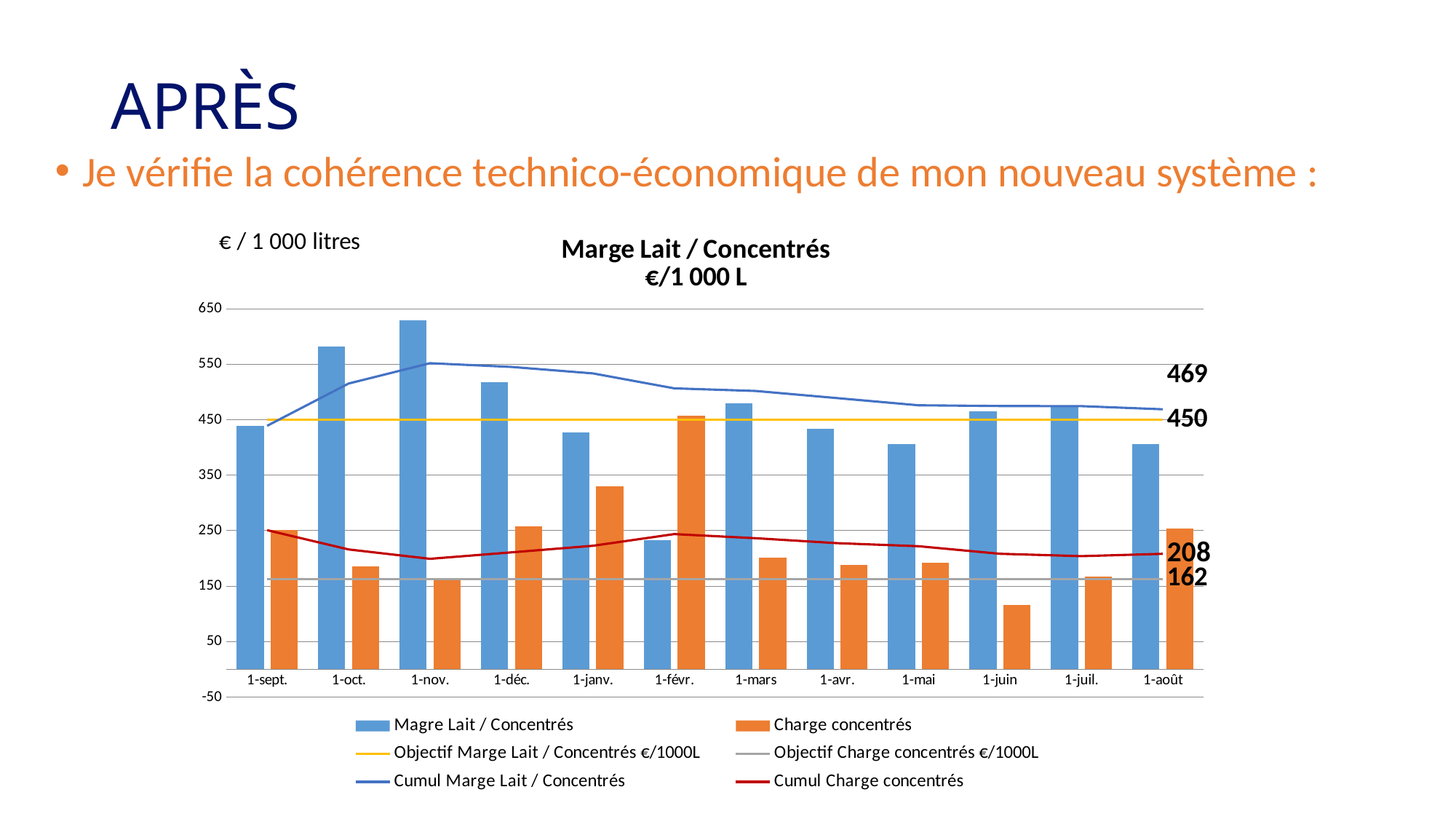
Is the Magre Lait / Concentrés value for 1-nov. greater or less than 550? greater In which month is the Magre Lait / Concentrés bar the highest? 1-nov. Which is larger, the Magre Lait / Concentrés bar for 1-oct. or for 1-déc.? 1-oct. What is the difference between the Cumul Charge concentrés value at 1-août (208) and the Objectif Charge concentrés (162)? 46 What is the value of Cumul Marge Lait / Concentrés at 1-août? 469 What is the value of Cumul Charge concentrés at 1-août? 208 What value is printed for the Objectif Marge Lait / Concentrés line? 450 By how much does the Cumul Marge Lait / Concentrés value at 1-août (469) exceed the Objectif Marge Lait / Concentrés (450)? 19 In which month is the Charge concentrés bar the lowest? 1-juin Is the Charge concentrés value for 1-juin greater or less than 150? less How many series does the legend list? 6 What value is printed for the Objectif Charge concentrés line? 162